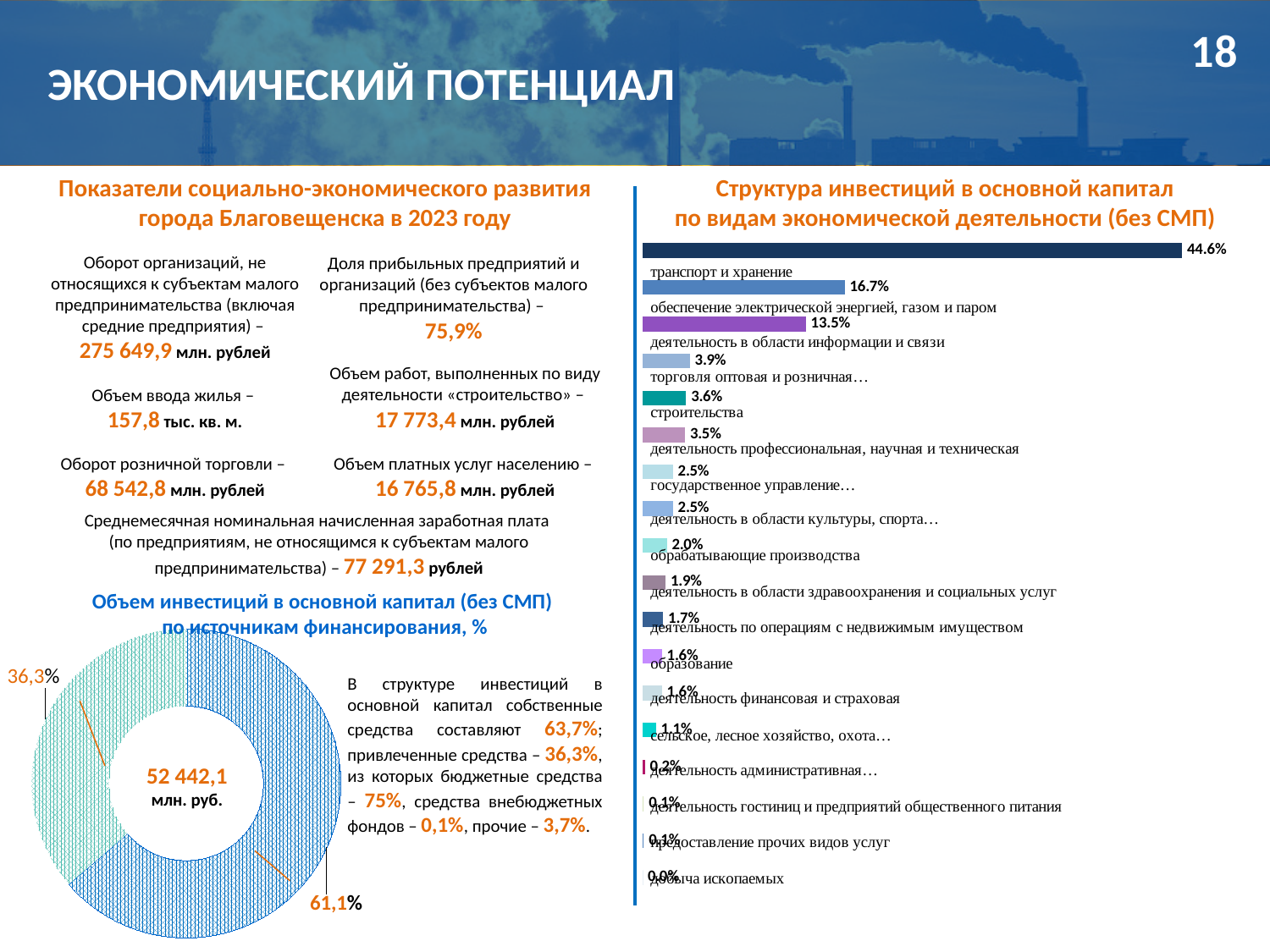
What value is printed in the centre of the chart 'Объем инвестиций в основной капитал (без СМП) по источникам финансирования, %'? 52 442,1 млн. руб. In the chart 'Структура инвестиций в основной капитал по видам экономической деятельности (без СМП)', what is the value for 'деятельность в области информации и связи'? 13.5% In the chart 'Структура инвестиций в основной капитал по видам экономической деятельности (без СМП)', which category has the highest value? транспорт и хранение In the chart 'Структура инвестиций в основной капитал по видам экономической деятельности (без СМП)', which category has the lowest value? добыча ископаемых In the chart 'Структура инвестиций в основной капитал по видам экономической деятельности (без СМП)', what is the value for 'обрабатывающие производства'? 2.0% In the chart 'Структура инвестиций в основной капитал по видам экономической деятельности (без СМП)', what is the value for 'транспорт и хранение'? 44.6% In the chart 'Структура инвестиций в основной капитал по видам экономической деятельности (без СМП)', which is larger: 'строительства' or 'торговля оптовая и розничная…'? торговля оптовая и розничная… In the chart 'Структура инвестиций в основной капитал по видам экономической деятельности (без СМП)', how many categories are shown? 18 In the chart 'Структура инвестиций в основной капитал по видам экономической деятельности (без СМП)', what is the value for 'сельское, лесное хозяйство, охота…'? 1.1% What kind of chart is 'Структура инвестиций в основной капитал по видам экономической деятельности (без СМП)'? bar chart What kind of chart is 'Объем инвестиций в основной капитал (без СМП) по источникам финансирования, %'? doughnut chart In the chart 'Структура инвестиций в основной капитал по видам экономической деятельности (без СМП)', what is the difference between 'транспорт и хранение' and 'обеспечение электрической энергией, газом и паром'? 27.9%